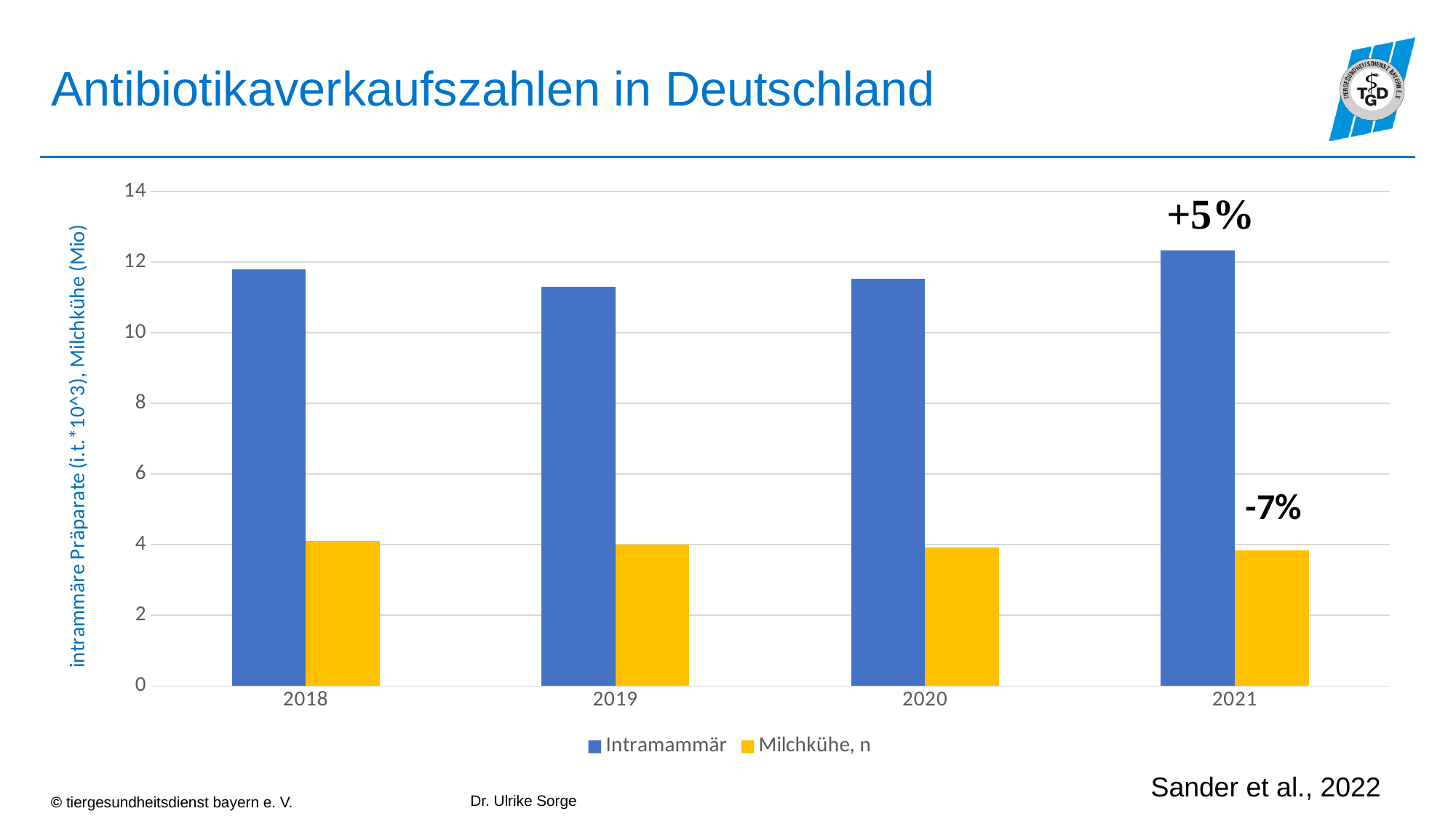
Is the Intramammär value for 2018 greater or less than 14? less In 2020, which is larger: Intramammär or Milchkühe, n? Intramammär What percentage change is annotated above the Intramammär bar for 2021? +5% Is the Milchkühe, n value for 2020 greater or less than 6? less How many series does the legend list? 2 What colour are the Milchkühe, n bars? yellow Do the Milchkühe, n values rise or fall from 2018 to 2021? fall Which year has the highest Intramammär value? 2021 Is the Intramammär value for 2021 greater or less than 12? greater What kind of chart is shown on the slide? bar chart How many years are shown on the x axis? 4